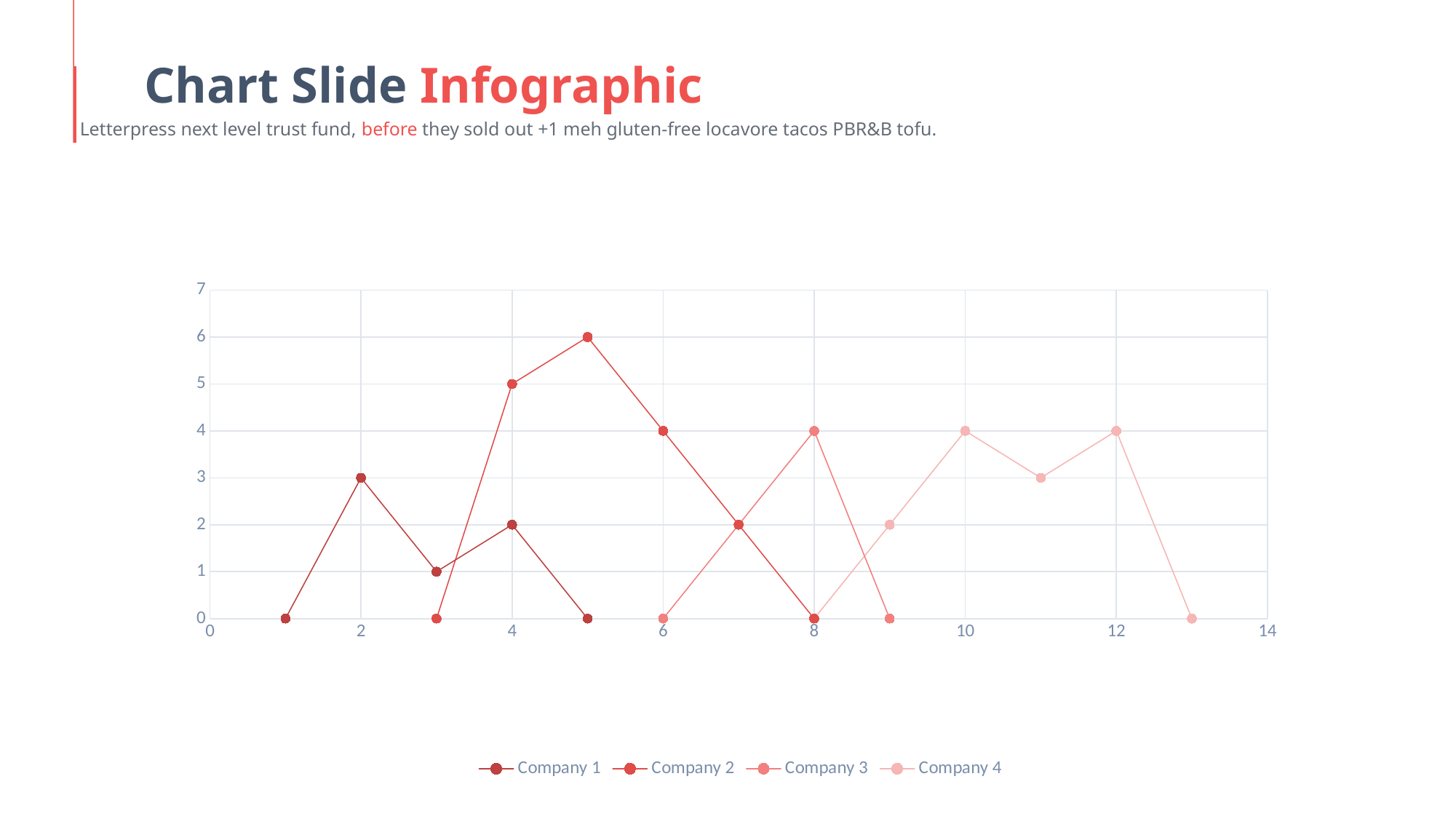
What is the difference between the peak value of Company 2 and the peak value of Company 1? 3 How many data points are plotted for Company 1? 5 What is the value of Company 1 at x = 4? 2 How many series does the legend list? 4 What is the highest value reached by Company 2? 6 What is the value of Company 3 at x = 8? 4 What is the value of Company 1 at x = 2? 3 Which series has the lowest peak value? Company 1 Is the value of Company 2 at x = 4 greater or less than 4? greater What type of chart is shown on the slide? Line chart What is the value of Company 4 at x = 10? 4 Which series reaches a higher peak, Company 1 or Company 2? Company 2